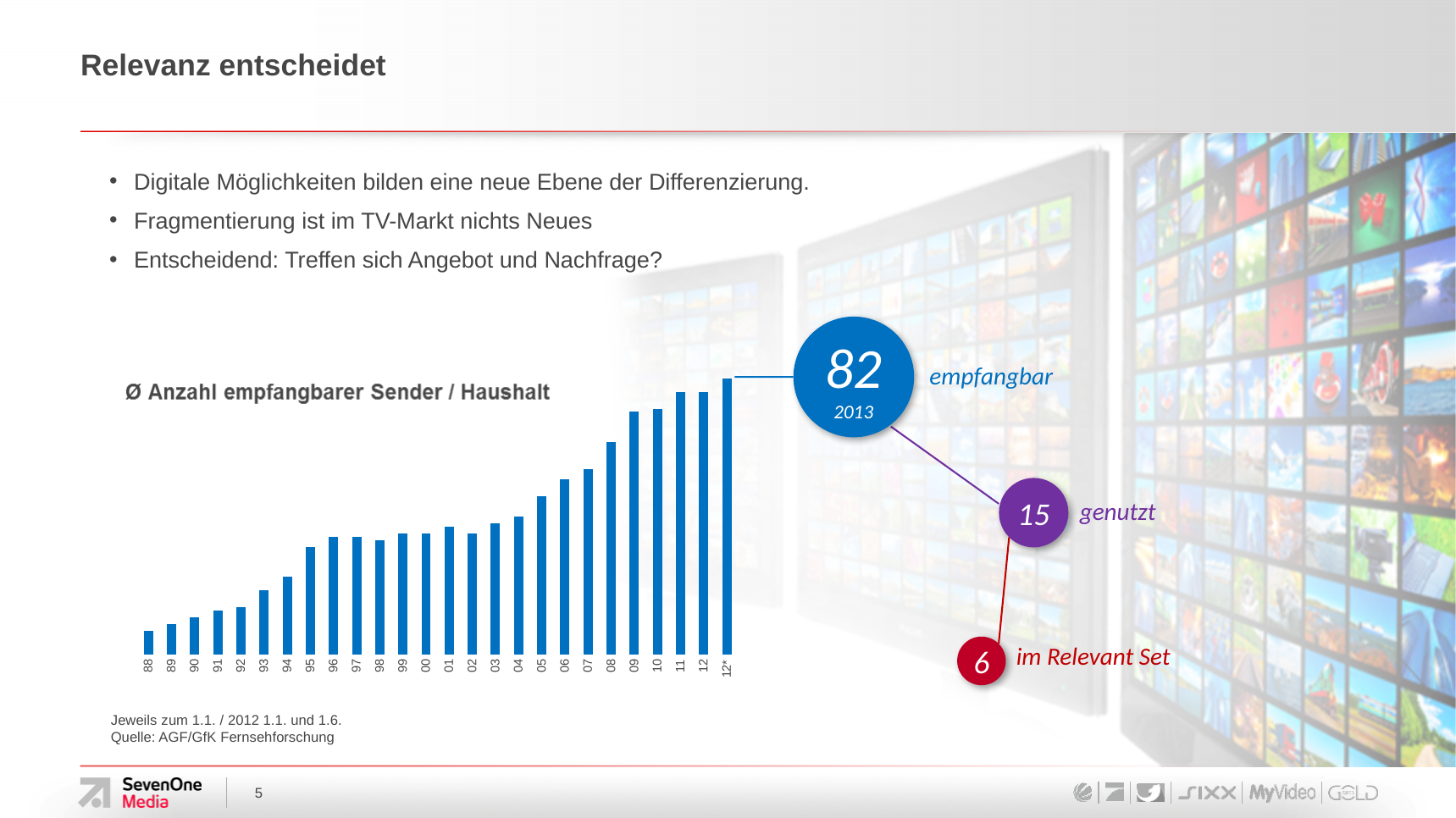
Which bar is taller, 88 or 12*? 12* What kind of chart is shown on the slide? bar chart Which bar is taller, 08 or 03? 08 What is the title of the chart? Ø Anzahl empfangbarer Sender / Haushalt Which bar is taller, 94 or 99? 99 Do the bar values generally rise or fall from 88 to 12*? rise Which year label has the highest bar? 12* Which year label has the lowest bar? 88 How many bars are plotted in the chart? 26 What is the first year label on the x axis of the chart? 88